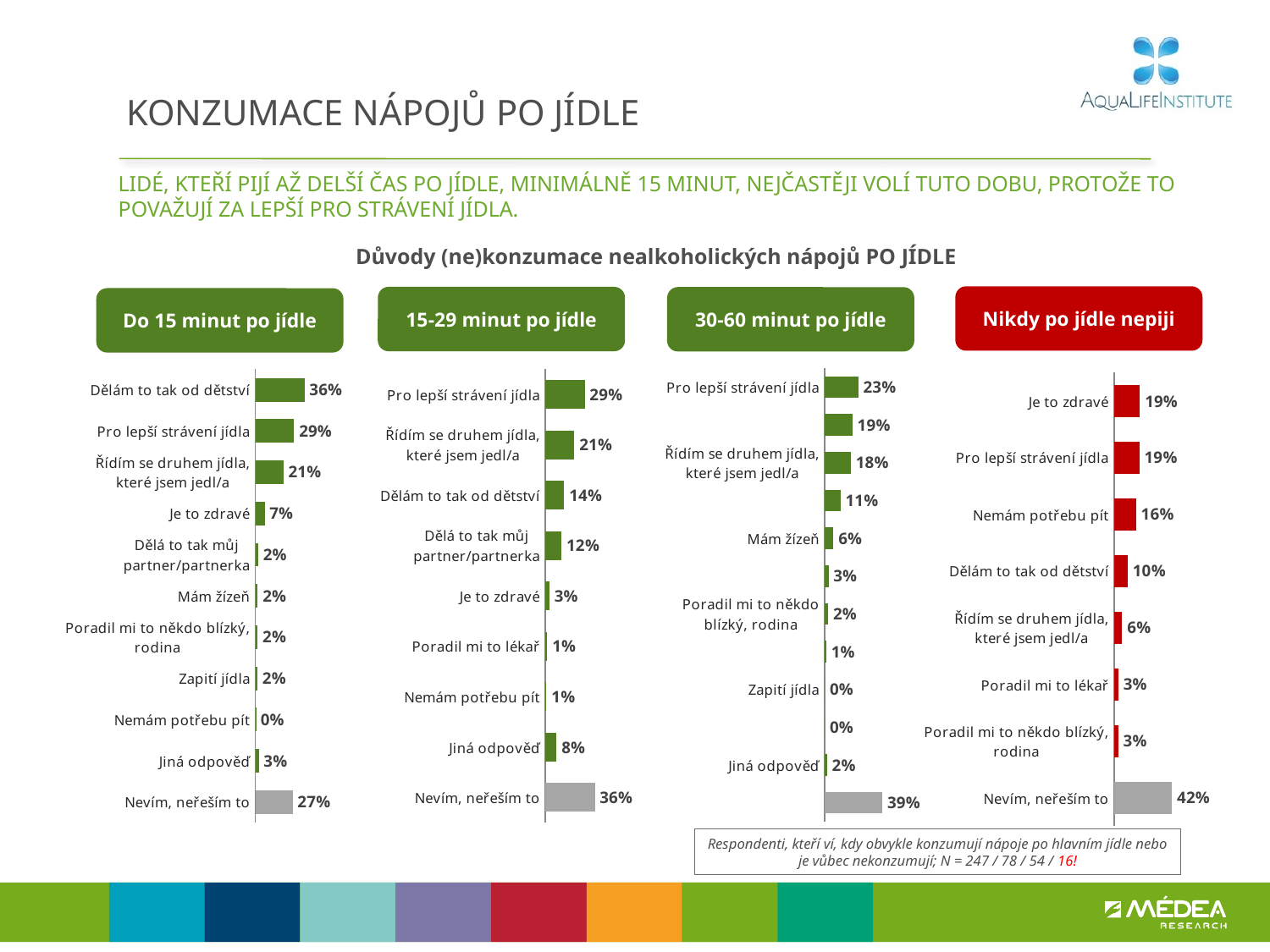
In the "15-29 minut po jídle" chart, which category has the highest value? Nevím, neřeším to In the "15-29 minut po jídle" chart, what is the difference between "Pro lepší strávení jídla" and "Dělám to tak od dětství"? 15% In the "Do 15 minut po jídle" chart, what is the value for "Nevím, neřeším to"? 27% In the "Nikdy po jídle nepiji" chart, what is the value for "Nemám potřebu pít"? 16% In the "15-29 minut po jídle" chart, what is the value for "Dělá to tak můj partner/partnerka"? 12% What colour are the bars in the "Nikdy po jídle nepiji" chart (excluding "Nevím, neřeším to")? Red In the "30-60 minut po jídle" chart, what is the value for "Pro lepší strávení jídla"? 23% In the "Do 15 minut po jídle" chart, what is the value for "Dělám to tak od dětství"? 36% In the "Nikdy po jídle nepiji" chart, which is larger: "Dělám to tak od dětství" or "Řídím se druhem jídla, které jsem jedl/a"? Dělám to tak od dětství In the "30-60 minut po jídle" chart, what is the value for "Nevím, neřeším to"? 39% How many categories are shown in the "Nikdy po jídle nepiji" chart? 8 What type of chart is used for "Do 15 minut po jídle"? Bar chart